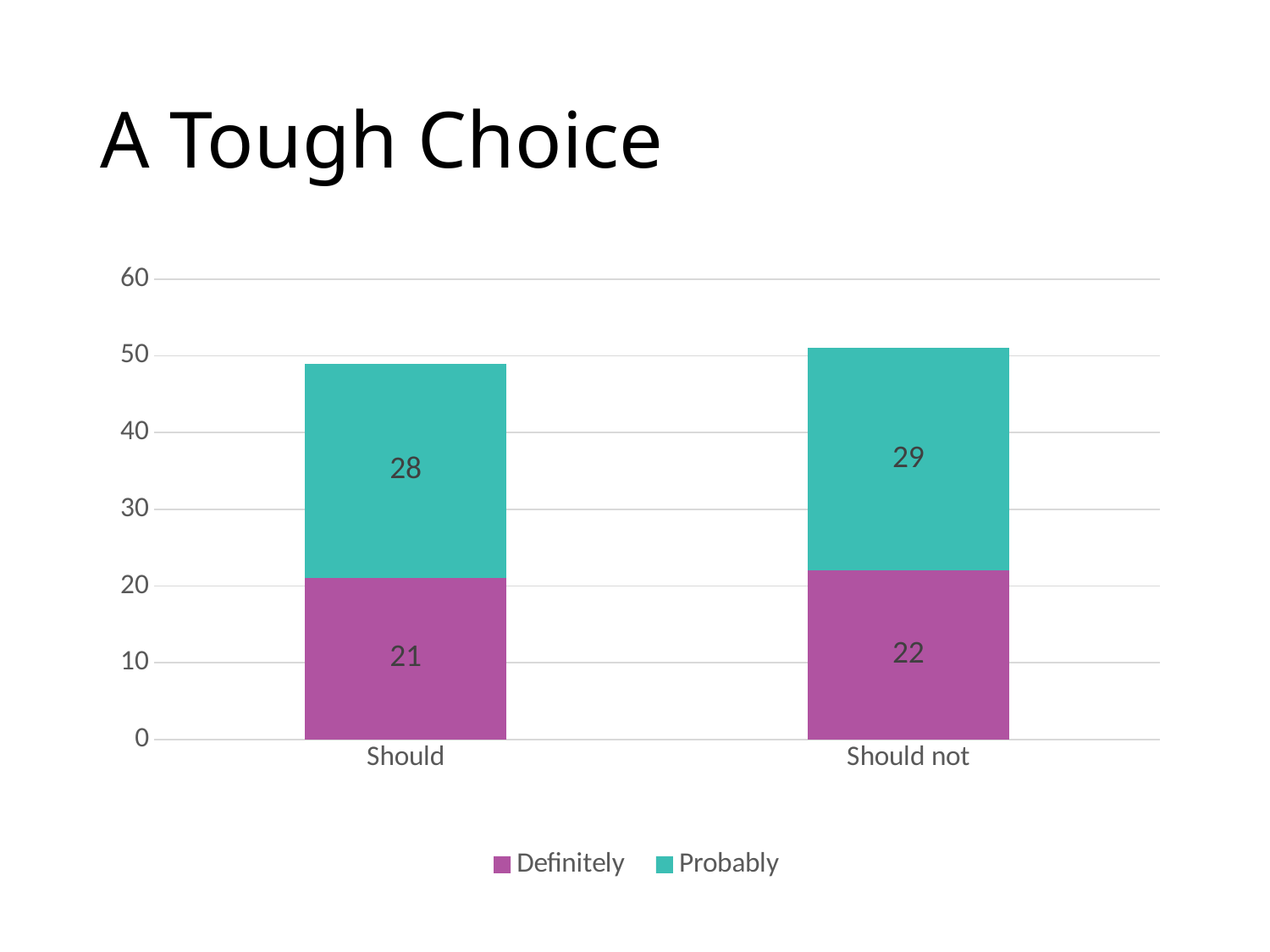
What is the difference between the Probably values for Should not and Should? 1 What is the total of the stacked bar for Should? 49 How many categories are shown on the x axis? 2 What kind of chart is shown on the slide? Stacked bar chart Which category has the larger Definitely value, Should or Should not? Should not What is the total of the stacked bar for Should not? 51 What is the value for Probably in the Should not category? 29 Which series is shown in purple in the legend? Definitely How many series does the legend list? 2 What is the value for Definitely in the Should category? 21 What is the value for Definitely in the Should not category? 22 What is the value for Probably in the Should category? 28